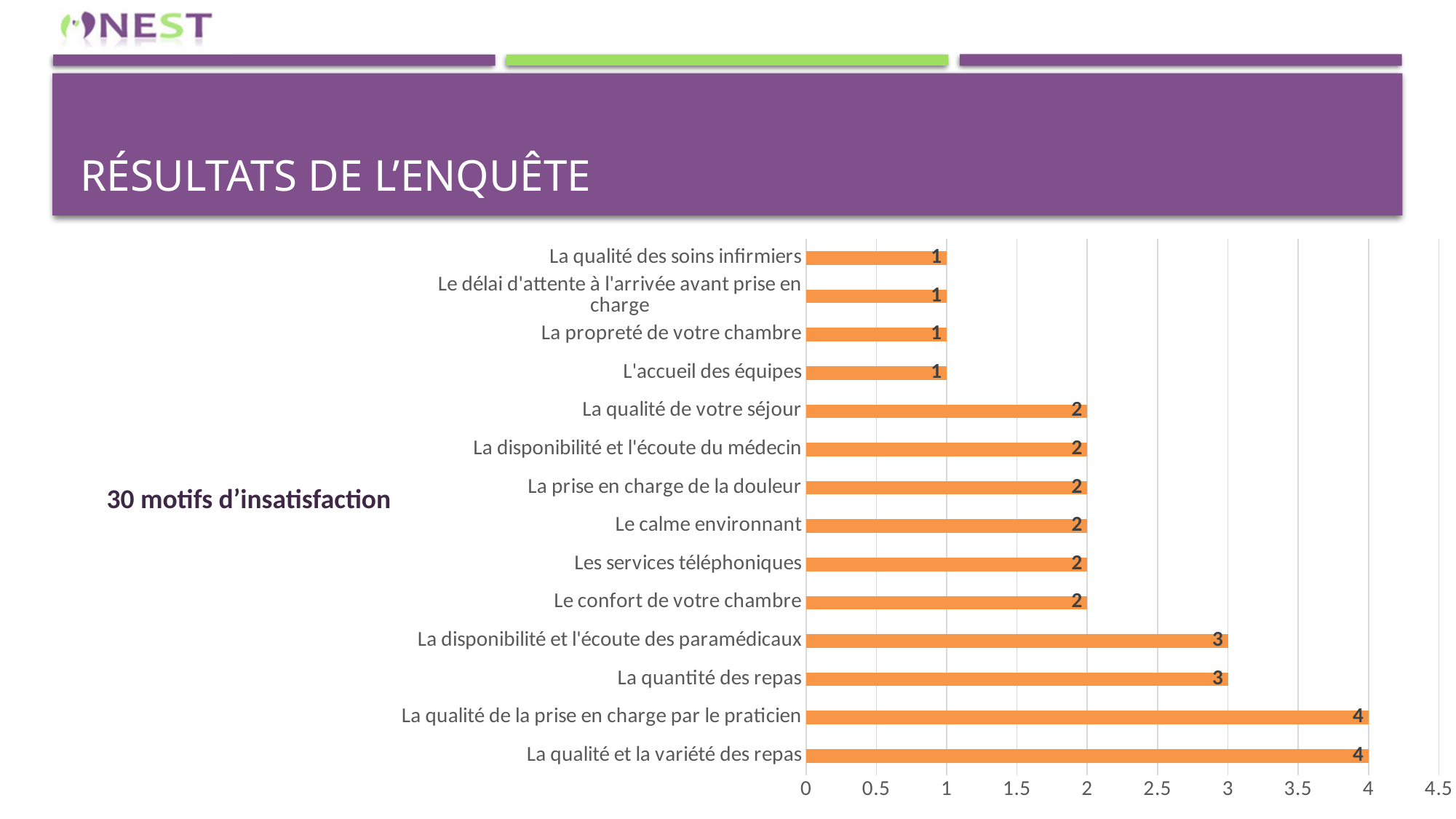
What is the lowest value shown in the chart? 1 How many categories are plotted in the chart? 14 What is the value for 'L'accueil des équipes'? 1 What is the value for 'La quantité des repas'? 3 What type of chart is shown on the slide? bar chart Which is larger: the value for 'La disponibilité et l'écoute des paramédicaux' or the value for 'Le calme environnant'? La disponibilité et l'écoute des paramédicaux What is the maximum value shown on the x axis? 4.5 What is the value for 'Le confort de votre chambre'? 2 What is the value for 'La qualité de la prise en charge par le praticien'? 4 What is the difference between the values for 'La qualité et la variété des repas' and 'La propreté de votre chambre'? 3 What text appears to the left of the chart describing the data? 30 motifs d'insatisfaction What is the highest value shown in the chart? 4